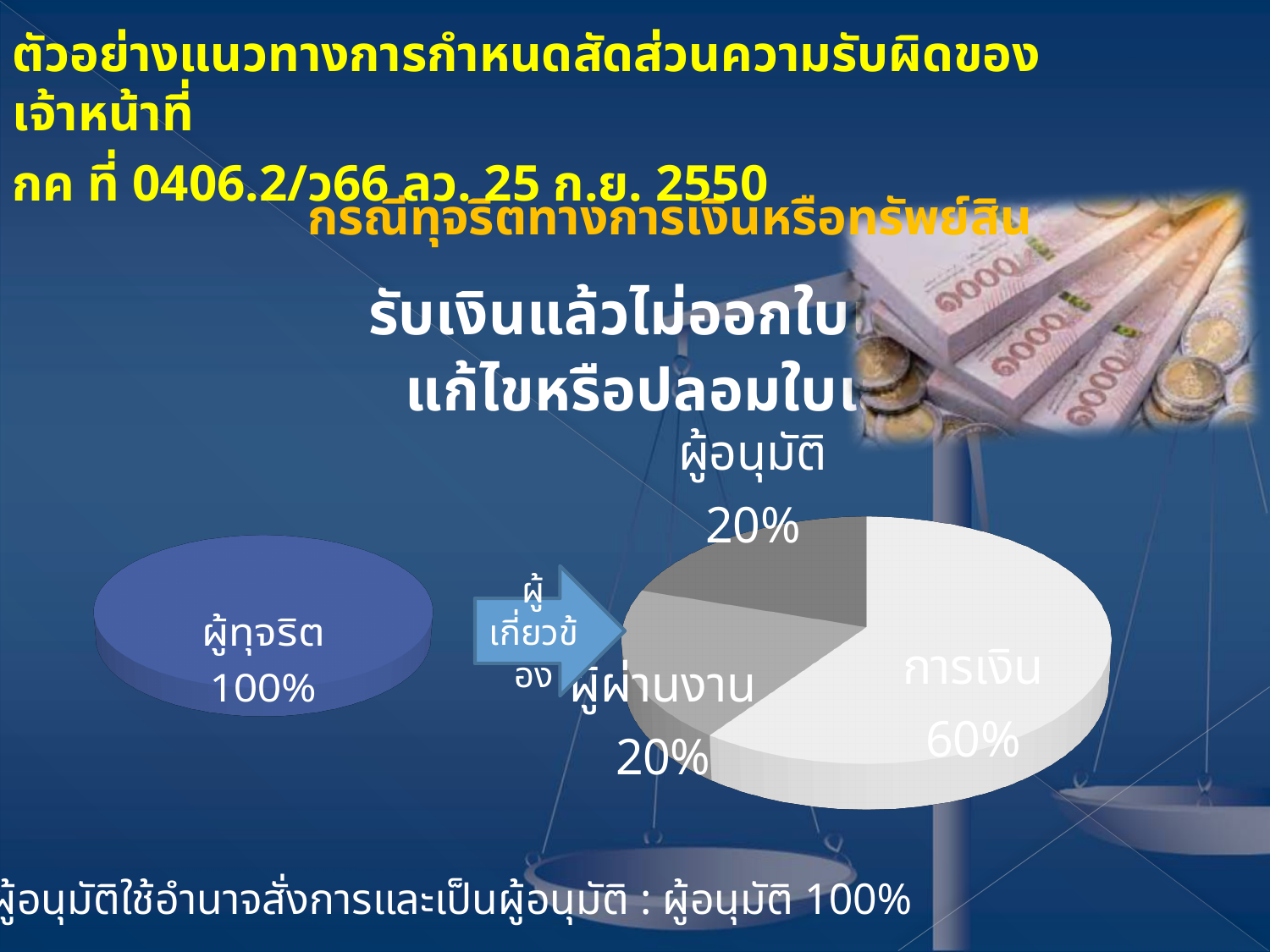
In the pie chart on the left, how many slices are there? 1 In the pie chart on the right, what share is labelled for การเงิน? 60% In the pie chart on the right, which category has the largest slice? การเงิน What kind of chart is the chart on the right side of the slide? pie chart In the pie chart on the right, what is the combined share of ผู้อนุมัติ and ผู้ผ่านงาน? 40% In the pie chart on the right, what is the difference between the shares of การเงิน and ผู้อนุมัติ? 40% In the pie chart on the right, how many slices are there? 3 In the pie chart on the left, what value is labelled for ผู้ทุจริต? 100% In the pie chart on the right, what share is labelled for ผู้อนุมัติ? 20% What kind of chart is the chart on the left side of the slide? pie chart In the pie chart on the right, which is larger, the share of การเงิน or the share of ผู้ผ่านงาน? การเงิน In the pie chart on the right, what share is labelled for ผู้ผ่านงาน? 20%